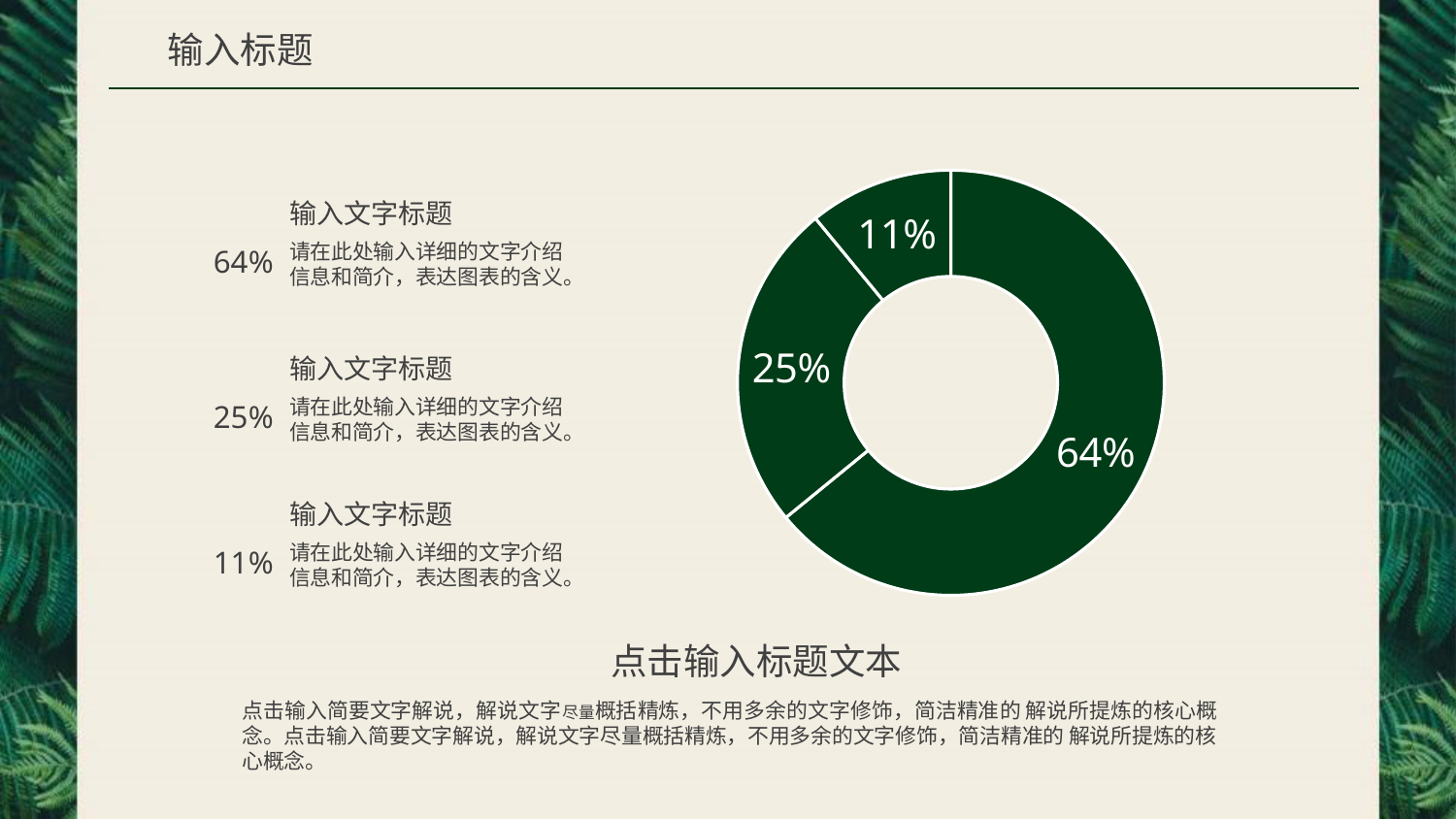
Is the largest slice of the donut chart greater or less than 50%? greater What share of the donut chart does the middle-sized slice represent? 25% How many slices does the donut chart have? 3 What colour are the slices of the donut chart? Dark green What is the value of the smallest slice in the donut chart? 11% What do the three slice values of the donut chart add up to? 100% What is the difference between the largest slice (64%) and the smallest slice (11%) in the donut chart? 53% Which percentage value appears in the donut chart but is not the largest or the smallest? 25% What is the difference between the 25% slice and the 11% slice in the donut chart? 14% Which is larger in the donut chart: the slice labelled 25% or the slice labelled 11%? 25% What kind of chart is shown on the slide? Donut chart What is the value of the largest slice in the donut chart? 64%